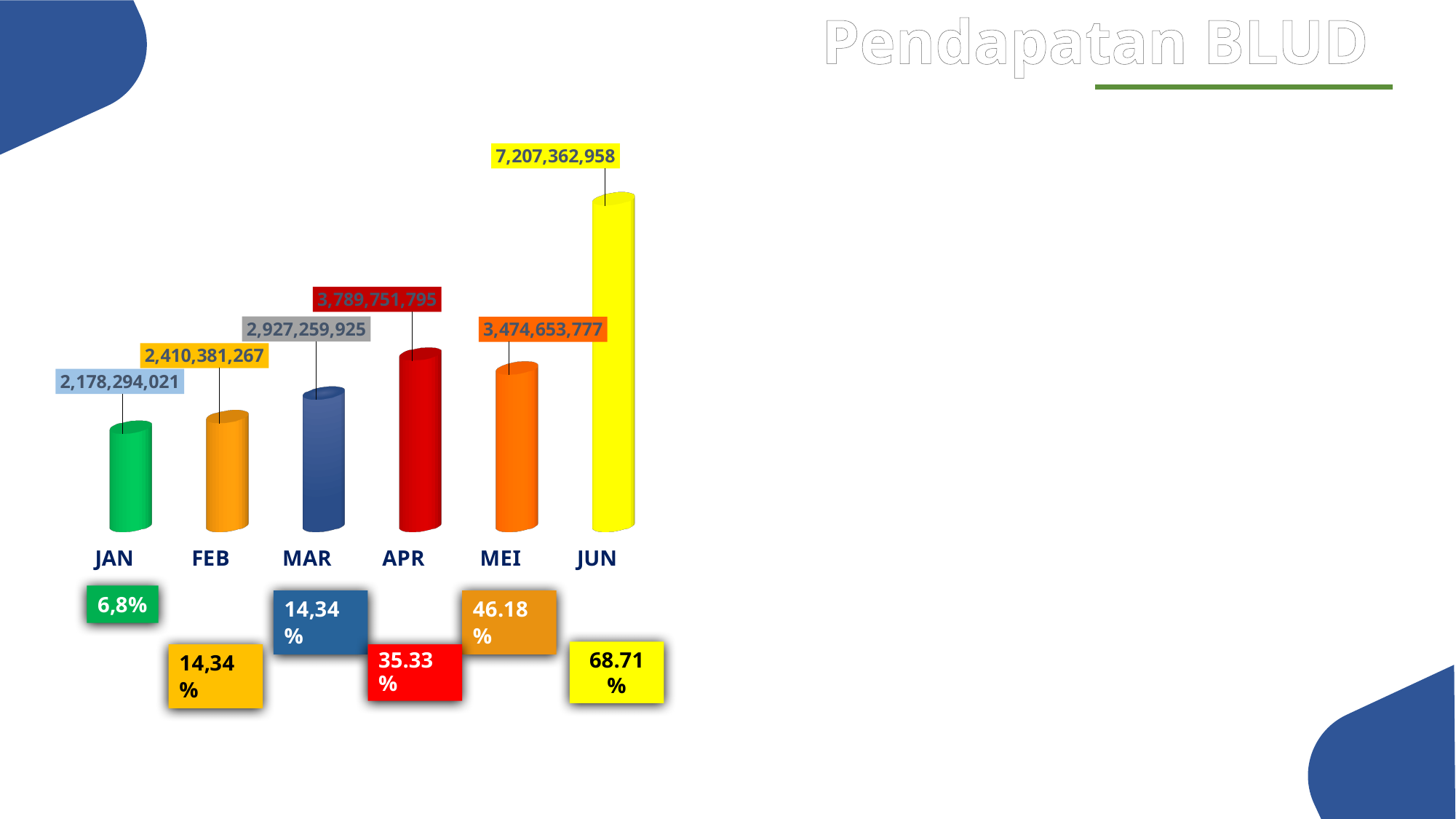
What is the difference between the values for APR and MEI? 315,098,018 What kind of chart is shown on the slide? Bar chart Which month has the lowest value? JAN How many months are shown on the chart? 6 What is the difference between the values for JUN and JAN? 5,029,068,937 What is the title of the slide containing the chart? Pendapatan BLUD Which month has the highest value? JUN What is the value for JUN? 7,207,362,958 What is the value for JAN? 2,178,294,021 Which is larger, the value for APR or the value for MEI? APR What is the value for MAR? 2,927,259,925 What is the value for MEI? 3,474,653,777